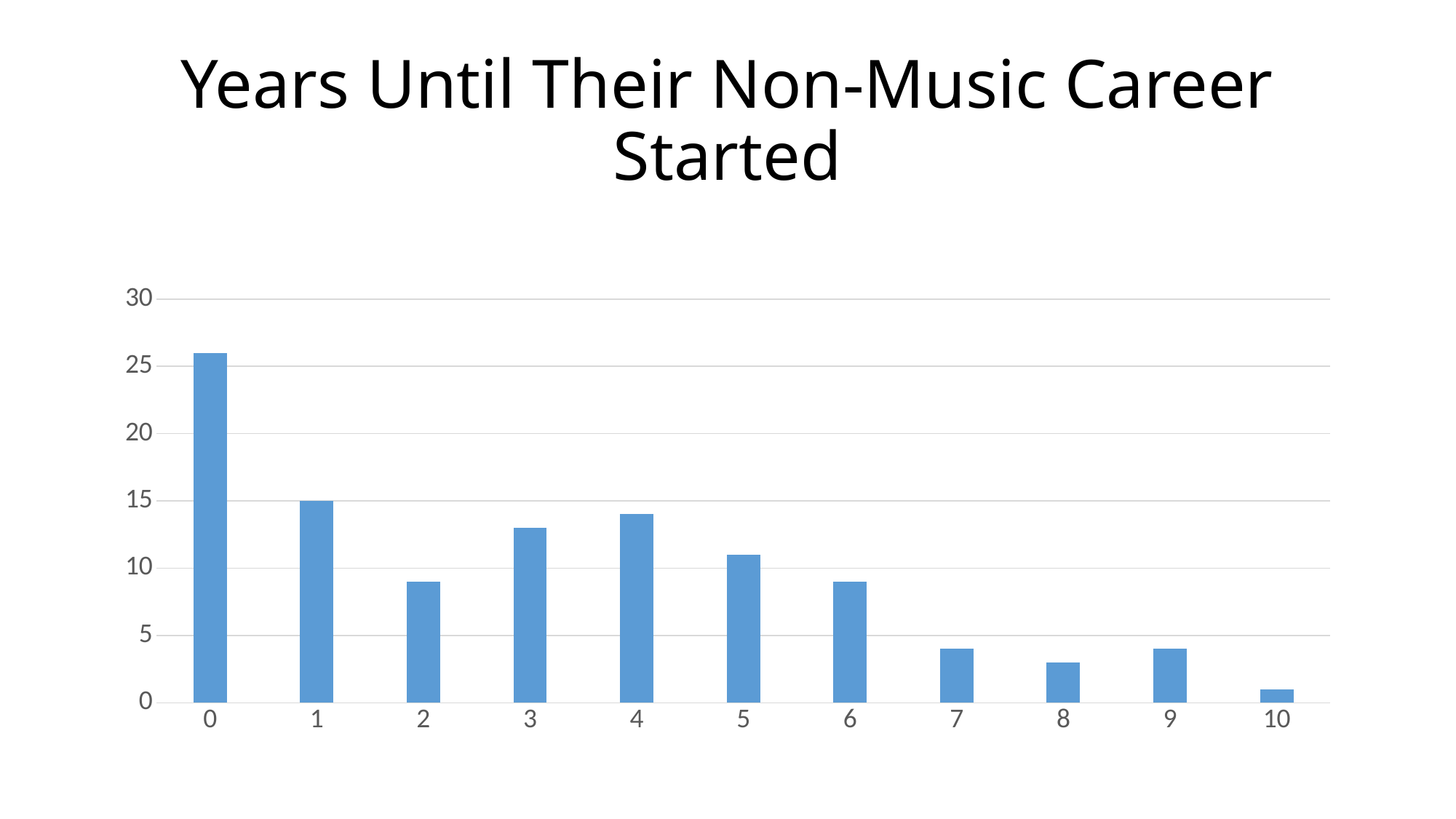
Which category has the lowest bar? 10 What is the value for category 1? 15 What kind of chart is shown on the slide? bar chart Is the value for category 7 greater or less than 5? less Which category has the highest bar? 0 Is the value for category 5 greater or less than 10? greater Is the value for category 0 greater or less than 25? greater Which is larger, the value for category 2 or the value for category 5? 5 How many categories are shown on the x axis? 11 Do the values generally rise or fall as the years increase from 0 to 10? fall What is the title of the chart? Years Until Their Non-Music Career Started